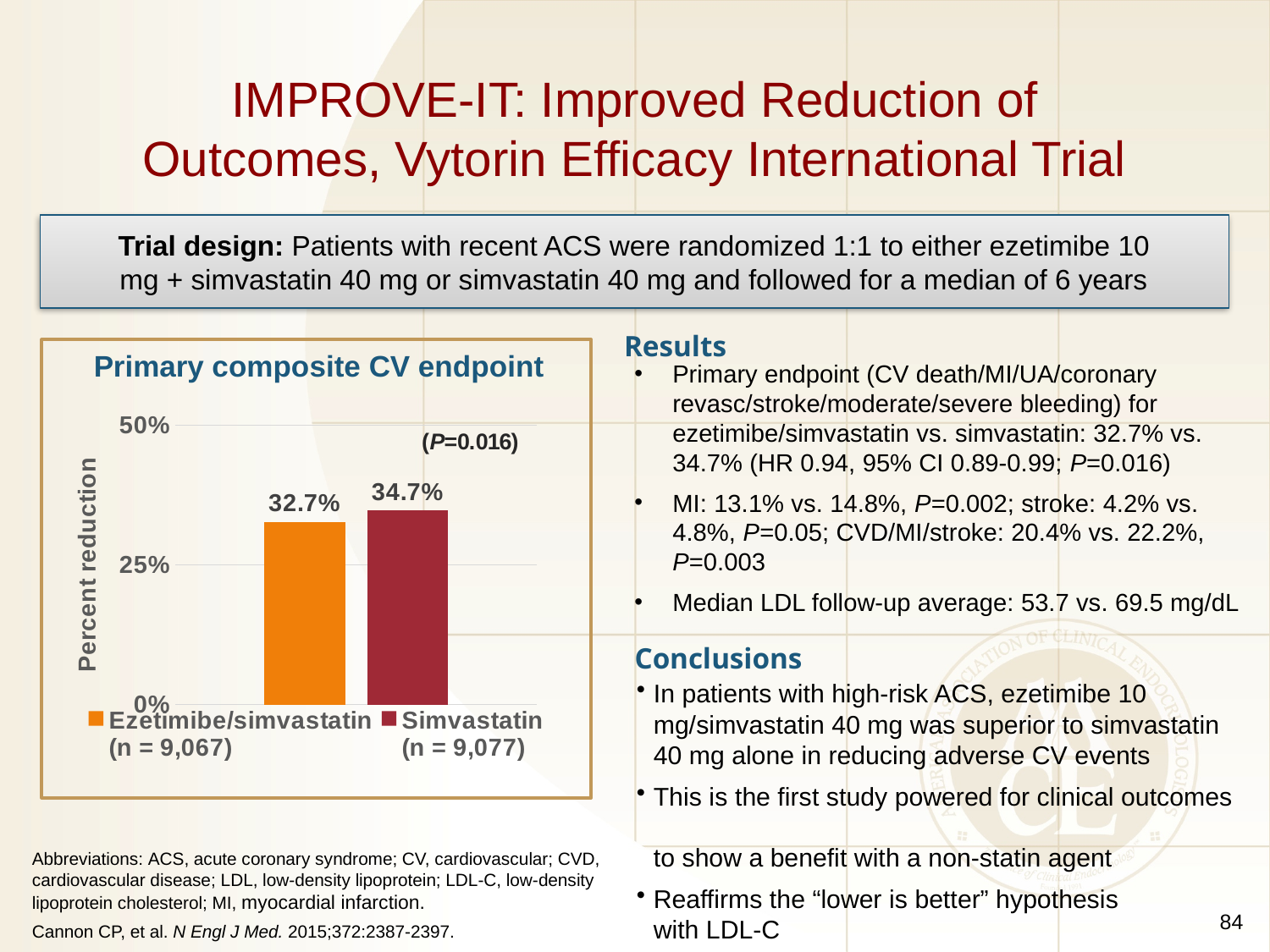
What P value is printed on the chart? P=0.016 What is the difference between the Simvastatin and Ezetimibe/simvastatin values in the chart? 2.0% How many bars are plotted in the Primary composite CV endpoint chart? 2 What is the value for Ezetimibe/simvastatin in the Primary composite CV endpoint chart? 32.7% Is the value for Ezetimibe/simvastatin greater or less than 50%? less What kind of chart is shown on the slide? Bar chart Is the value for Simvastatin greater or less than 25%? greater How many series does the legend of the chart list? 2 Which group has the higher value in the Primary composite CV endpoint chart? Simvastatin What is the value for Simvastatin in the Primary composite CV endpoint chart? 34.7% Which group has the lower value in the Primary composite CV endpoint chart? Ezetimibe/simvastatin Is the value for Ezetimibe/simvastatin larger or smaller than the value for Simvastatin? smaller